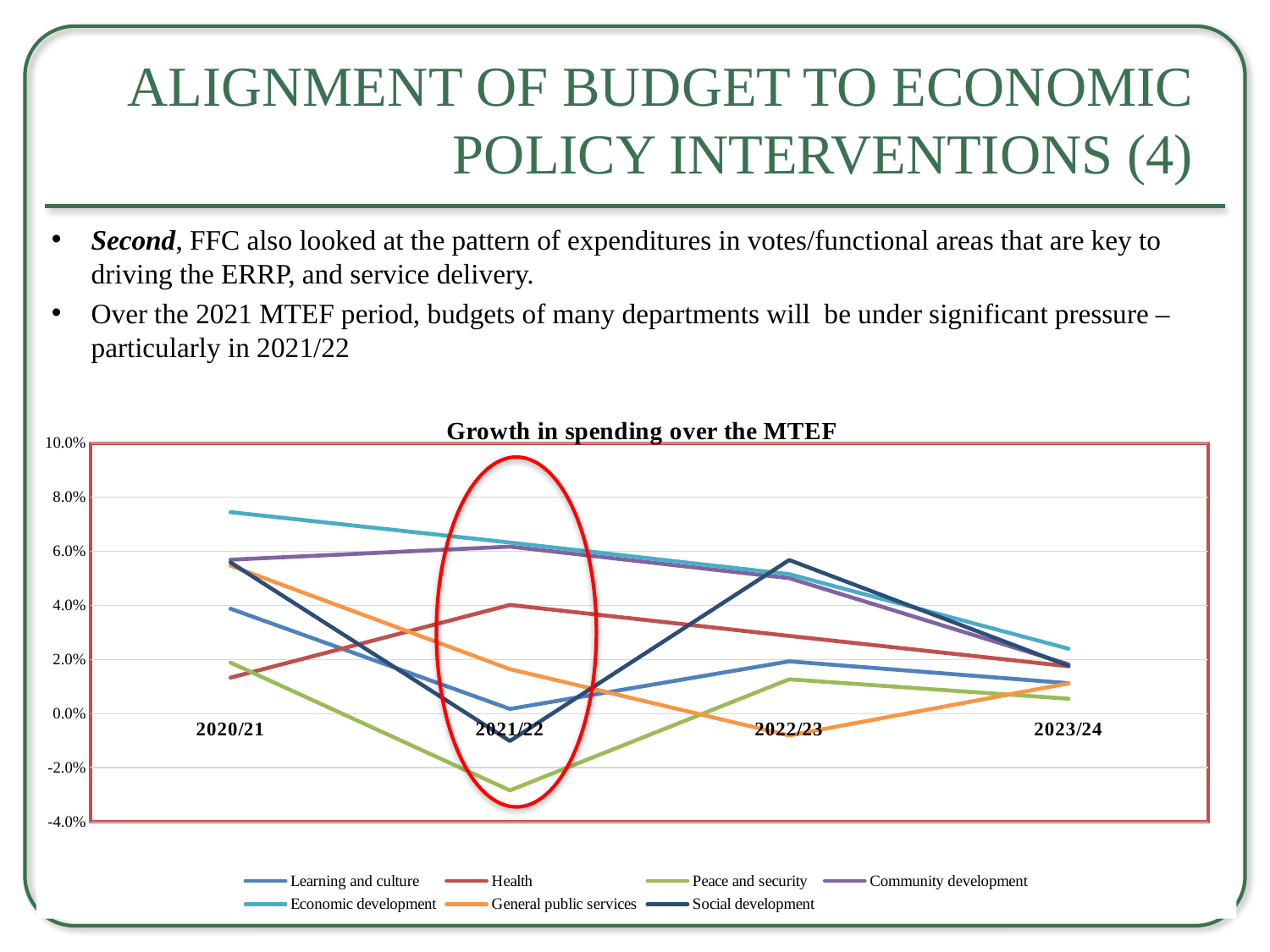
Which series has the lowest value in 2021/22? Peace and security In 2021/22, which is larger: the value for Health or the value for Learning and culture? Health Is the value for Peace and security in 2021/22 greater or less than -2.0%? less Which series has the highest value in 2020/21? Economic development How many periods are shown on the x axis of the chart? 4 What is the title of the chart? Growth in spending over the MTEF How many series does the legend of the chart list? 7 Is the value for Social development in 2021/22 greater or less than 0.0%? less What kind of chart is shown on the slide? line chart Is the value for Economic development in 2020/21 greater or less than 6.0%? greater What colour is the Health line in the chart? red Does the Economic development line rise or fall from 2020/21 to 2023/24? fall